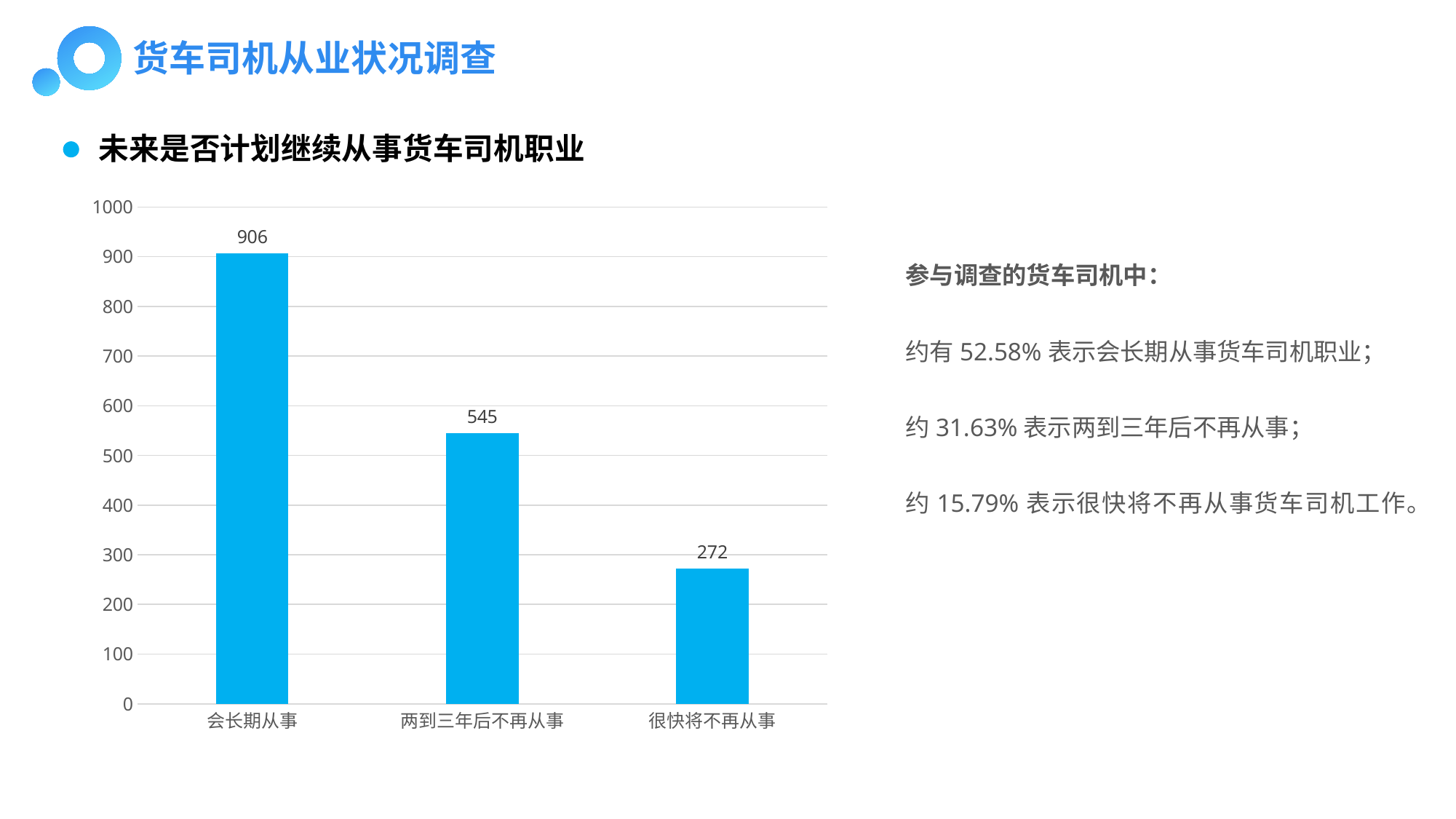
What is the value for 很快将不再从事? 272 What is the difference between the values for 会长期从事 and 两到三年后不再从事? 361 What is the difference between the values for 两到三年后不再从事 and 很快将不再从事? 273 How many categories are shown in the chart? 3 Which category has the lowest value? 很快将不再从事 Do the values rise or fall from left to right across the categories? fall Which category has the highest value? 会长期从事 What is the value for 会长期从事? 906 Is the value for 会长期从事 greater or less than 900? greater What kind of chart is shown on the slide? bar chart Which is larger, the value for 两到三年后不再从事 or the value for 很快将不再从事? 两到三年后不再从事 What is the value for 两到三年后不再从事? 545